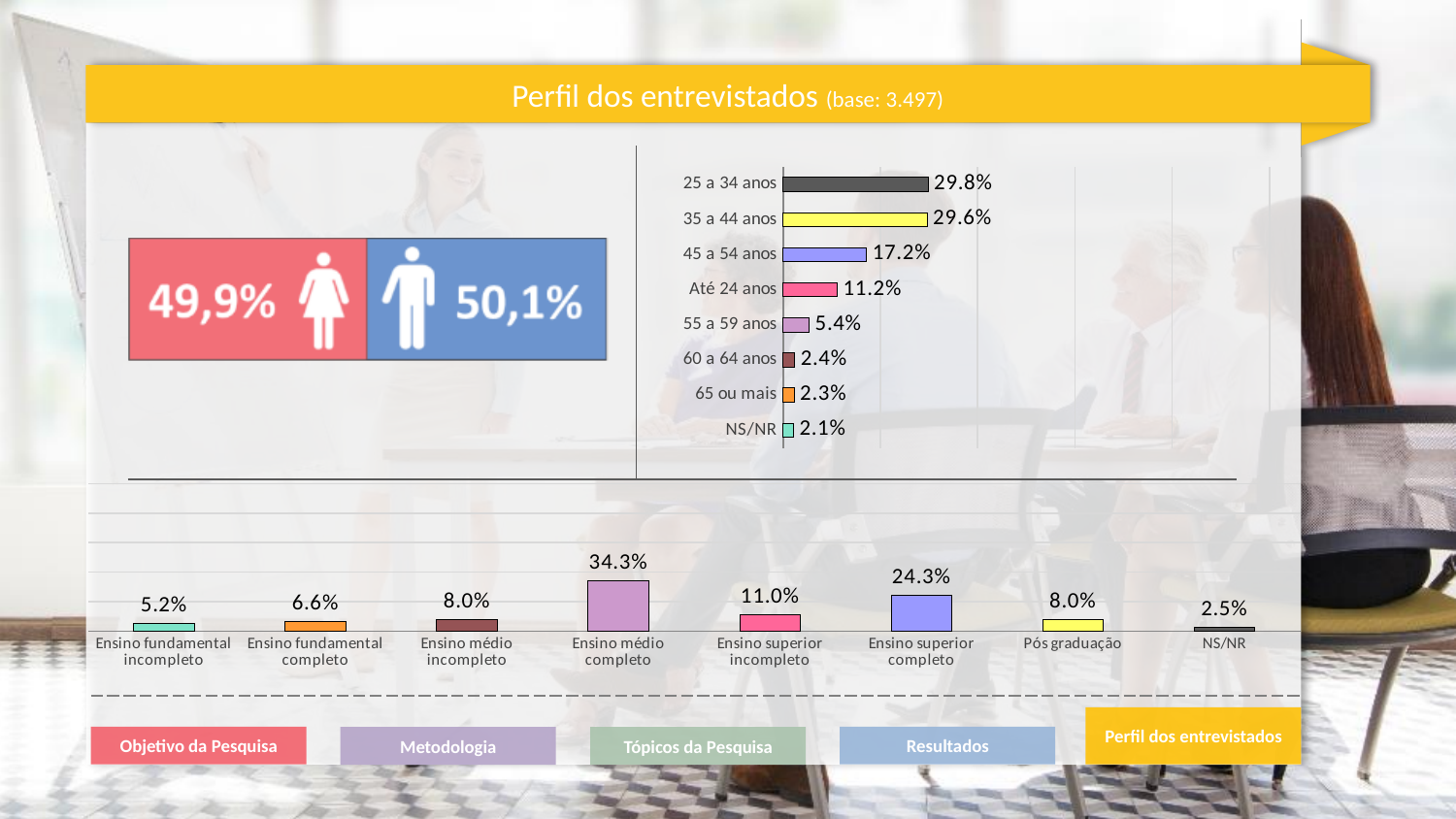
In the education-level bar chart at the bottom, which category has the lowest value? NS/NR In the education-level bar chart at the bottom, what is the value for Ensino superior completo? 24.3% In the age-group bar chart, what is the value for 45 a 54 anos? 17.2% In the age-group bar chart, which is larger: 55 a 59 anos or Até 24 anos? Até 24 anos In the age-group bar chart, how many age categories are shown? 8 In the education-level bar chart at the bottom, what is the difference between Ensino médio completo and Ensino superior incompleto? 23.3% In the education-level bar chart at the bottom, which category has the highest value? Ensino médio completo In the age-group bar chart, what is the value for Até 24 anos? 11.2% What is the base (number of respondents) stated in the slide title? 3.497 In the education-level bar chart at the bottom, how many categories are shown? 8 What kind of chart is the age-group chart at the top right of the slide? Bar chart In the age-group bar chart, what is the difference between 25 a 34 anos and 45 a 54 anos? 12.6%